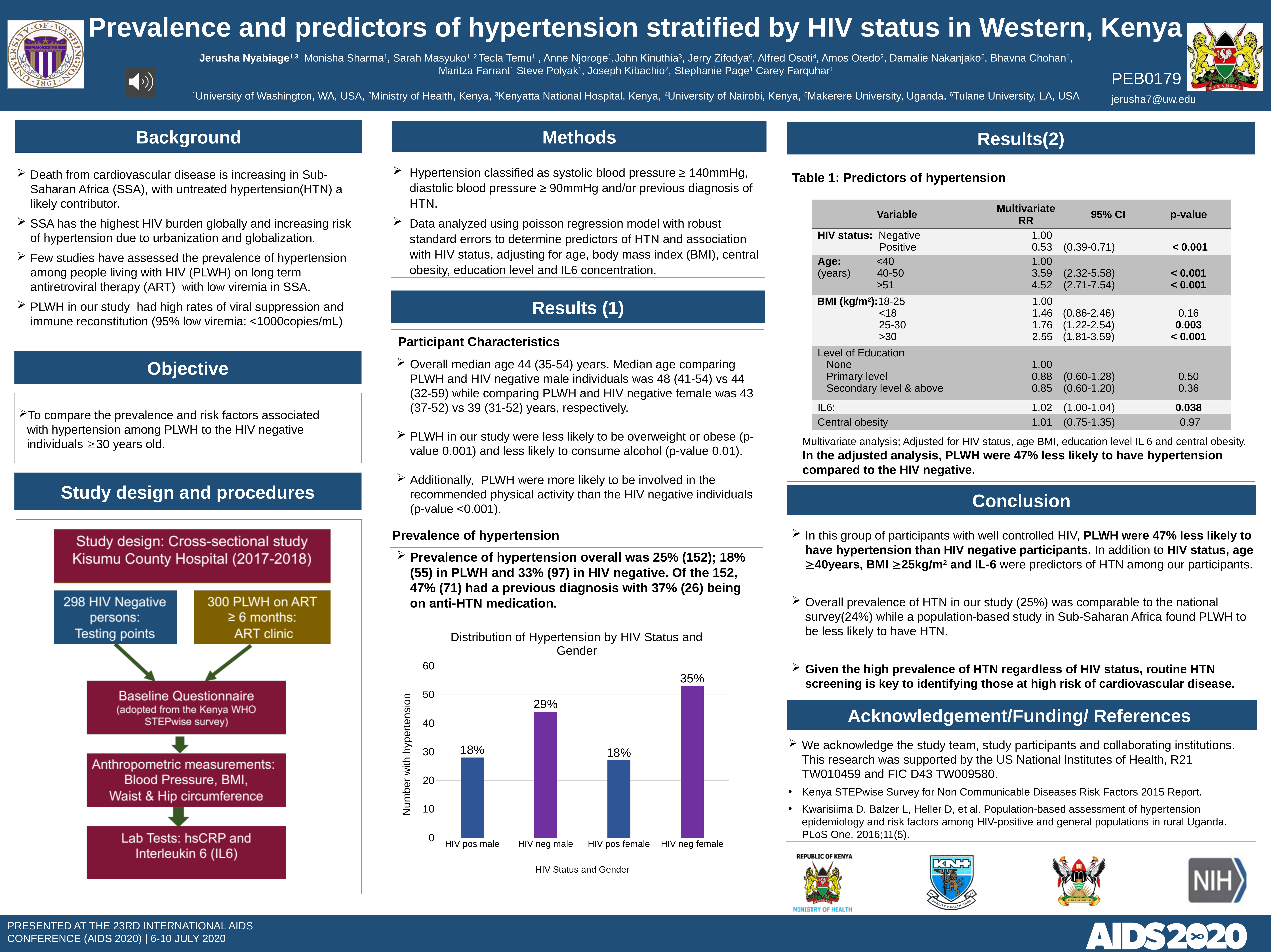
What percentage label is shown above the bar for HIV pos male? 18% What percentage label is shown above the bar for HIV neg female? 35% Is the bar for HIV neg female greater or less than 50 on the y axis? greater Which category has the tallest bar in the chart? HIV neg female What percentage label is shown above the bar for HIV neg male? 29% How many categories are plotted on the x axis of the chart? 4 Which bar is taller, HIV neg male or HIV pos male? HIV neg male What percentage label is shown above the bar for HIV pos female? 18% What type of chart is shown on the slide? bar chart What is the label of the y axis of the chart? Number with hypertension What is the title of the chart on the slide? Distribution of Hypertension by HIV Status and Gender